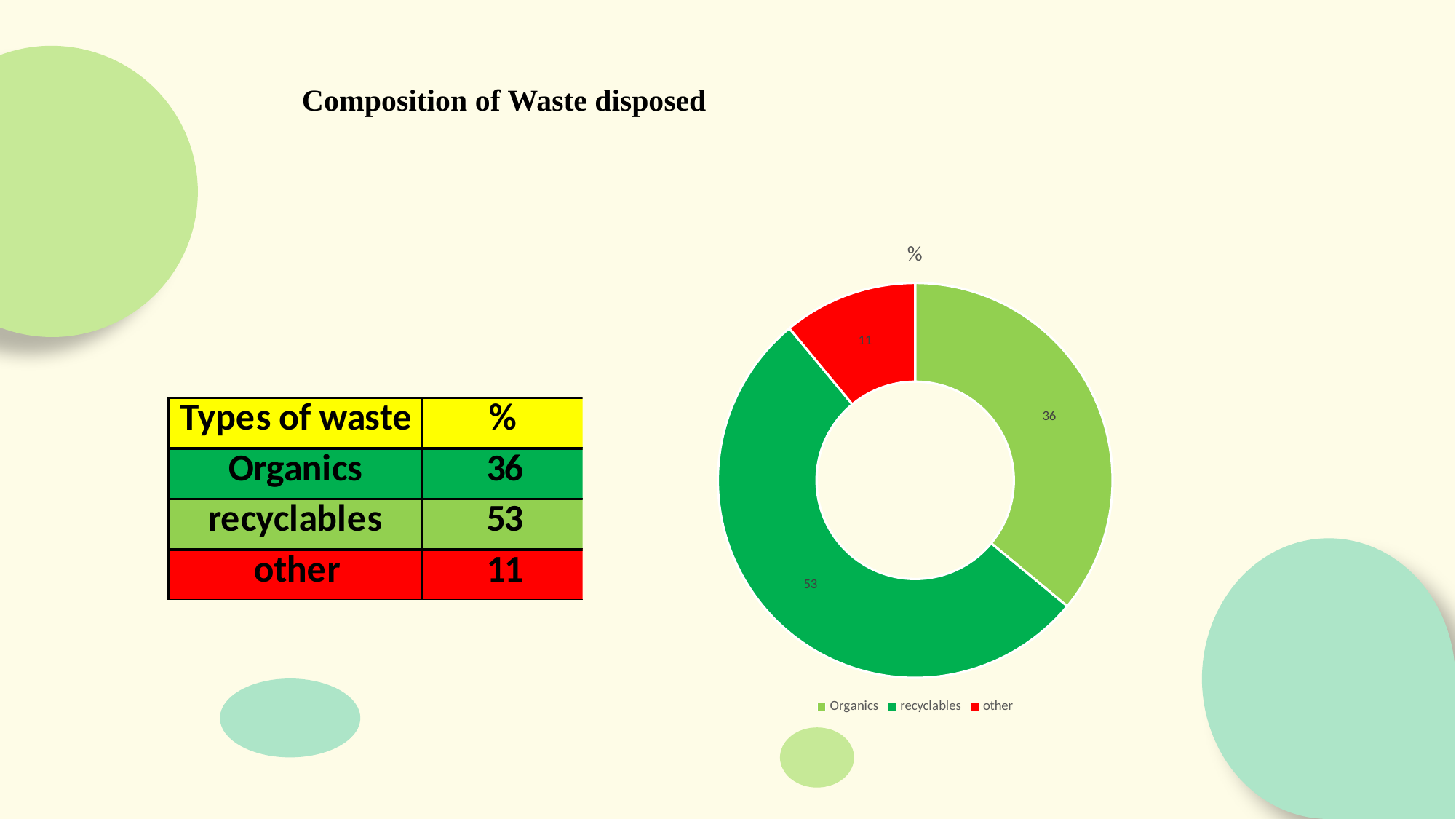
What is the value shown for other in the chart? 11 Which category has the largest slice in the chart? recyclables What kind of chart is shown on the slide? doughnut chart What is the difference between the values for Organics and other? 25 What is the title of the chart? % What is the value shown for recyclables in the chart? 53 What is the difference between the values for recyclables and Organics? 17 How many categories are shown in the chart? 3 Which is larger, the value for Organics or the value for other? Organics What is the value shown for Organics in the chart? 36 What share of the whole does the recyclables slice represent? 53% Which category has the smallest slice in the chart? other